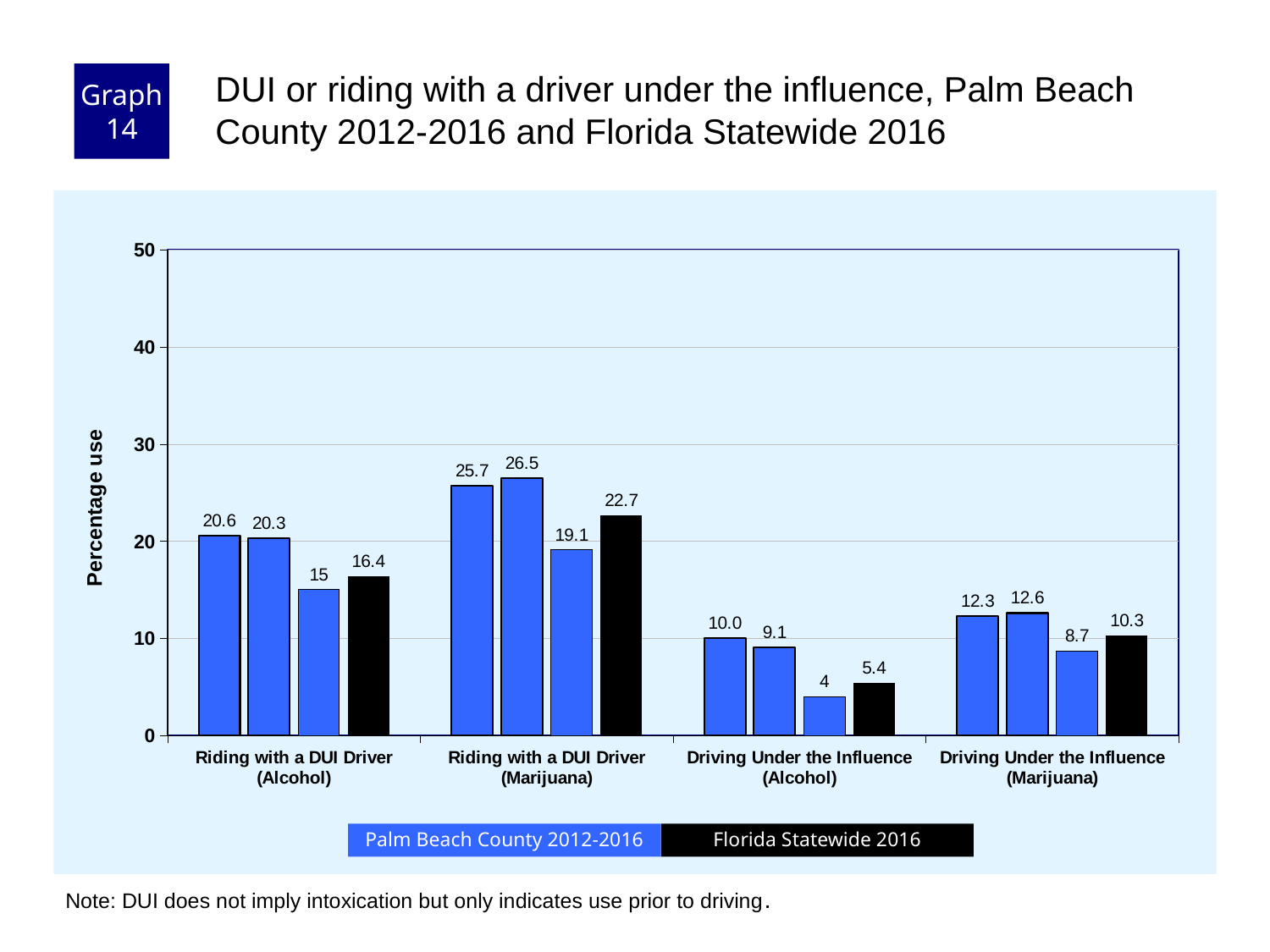
Which category has the highest Florida Statewide 2016 value? Riding with a DUI Driver (Marijuana) What is the Florida Statewide 2016 value for Riding with a DUI Driver (Marijuana)? 22.7 What is the Florida Statewide 2016 value for Driving Under the Influence (Marijuana)? 10.3 What is the lowest value shown on the chart? 4 What is the highest value shown on the chart? 26.5 What kind of chart is shown on the slide? bar chart What is the Florida Statewide 2016 value for Driving Under the Influence (Alcohol)? 5.4 Is the Florida Statewide 2016 value for Riding with a DUI Driver (Alcohol) larger or smaller than the Florida Statewide 2016 value for Driving Under the Influence (Marijuana)? larger Which category has the lowest Florida Statewide 2016 value? Driving Under the Influence (Alcohol) What is the Florida Statewide 2016 value for Riding with a DUI Driver (Alcohol)? 16.4 What is the difference between the Florida Statewide 2016 values for Riding with a DUI Driver (Marijuana) and Riding with a DUI Driver (Alcohol)? 6.3 How many categories are shown on the x axis? 4